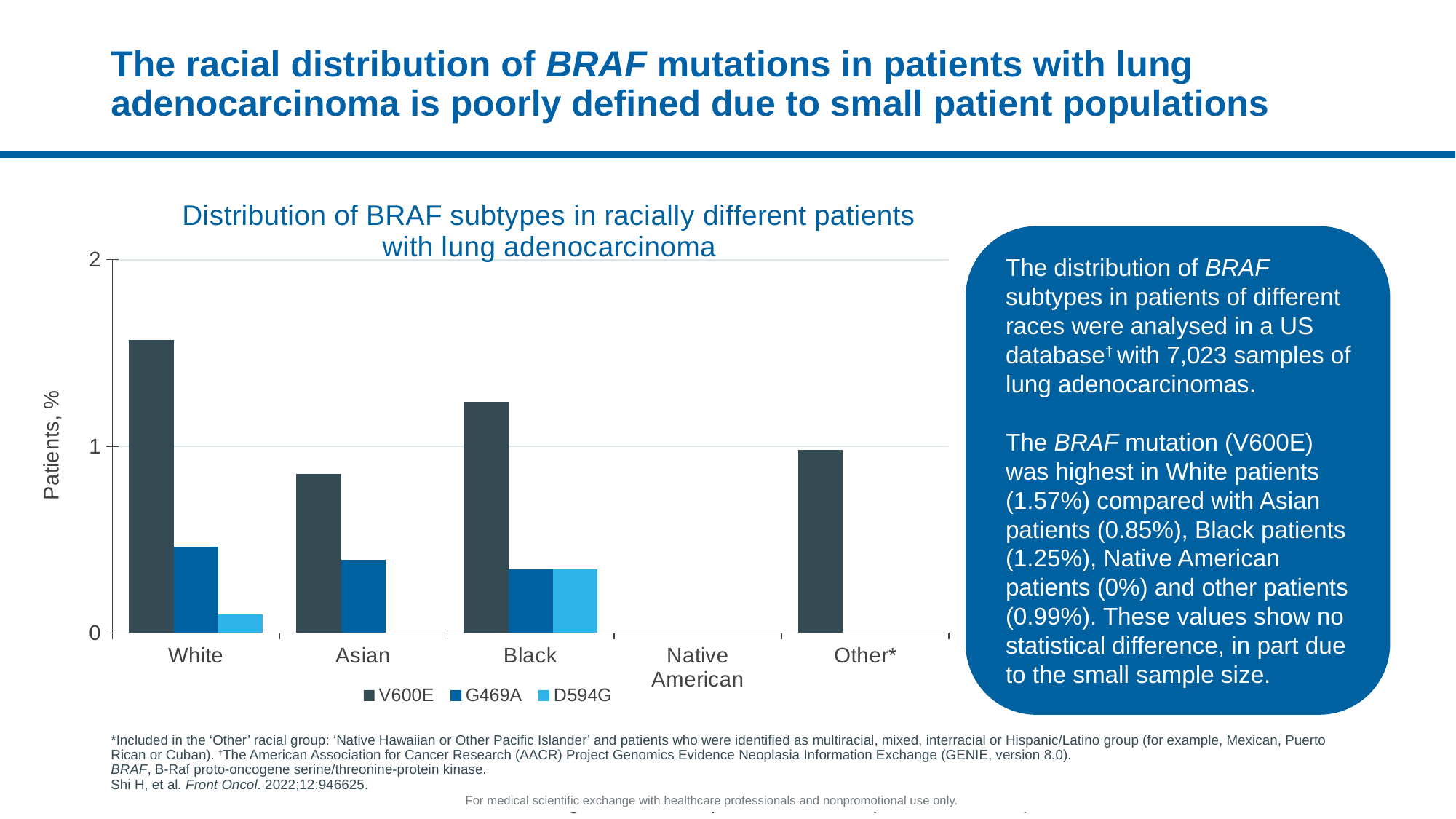
Is the V600E value for Other* patients greater or less than 1? less What is the V600E value for Native American patients? 0% According to the slide, what is the V600E value for White patients? 1.57% How many racial groups are shown on the x axis of the chart? 5 Which is larger, the V600E value for Black patients or for Asian patients? Black Which racial group has the highest V600E value? White How many series does the chart legend list? 3 Is the V600E value for Black patients greater or less than 1? greater What kind of chart is shown on the slide? Bar chart Which racial group has the lowest V600E value? Native American What is the difference between the V600E values for White patients (1.57%) and Asian patients (0.85%) stated on the slide? 0.72% What are the three BRAF subtypes listed in the chart legend? V600E, G469A, D594G